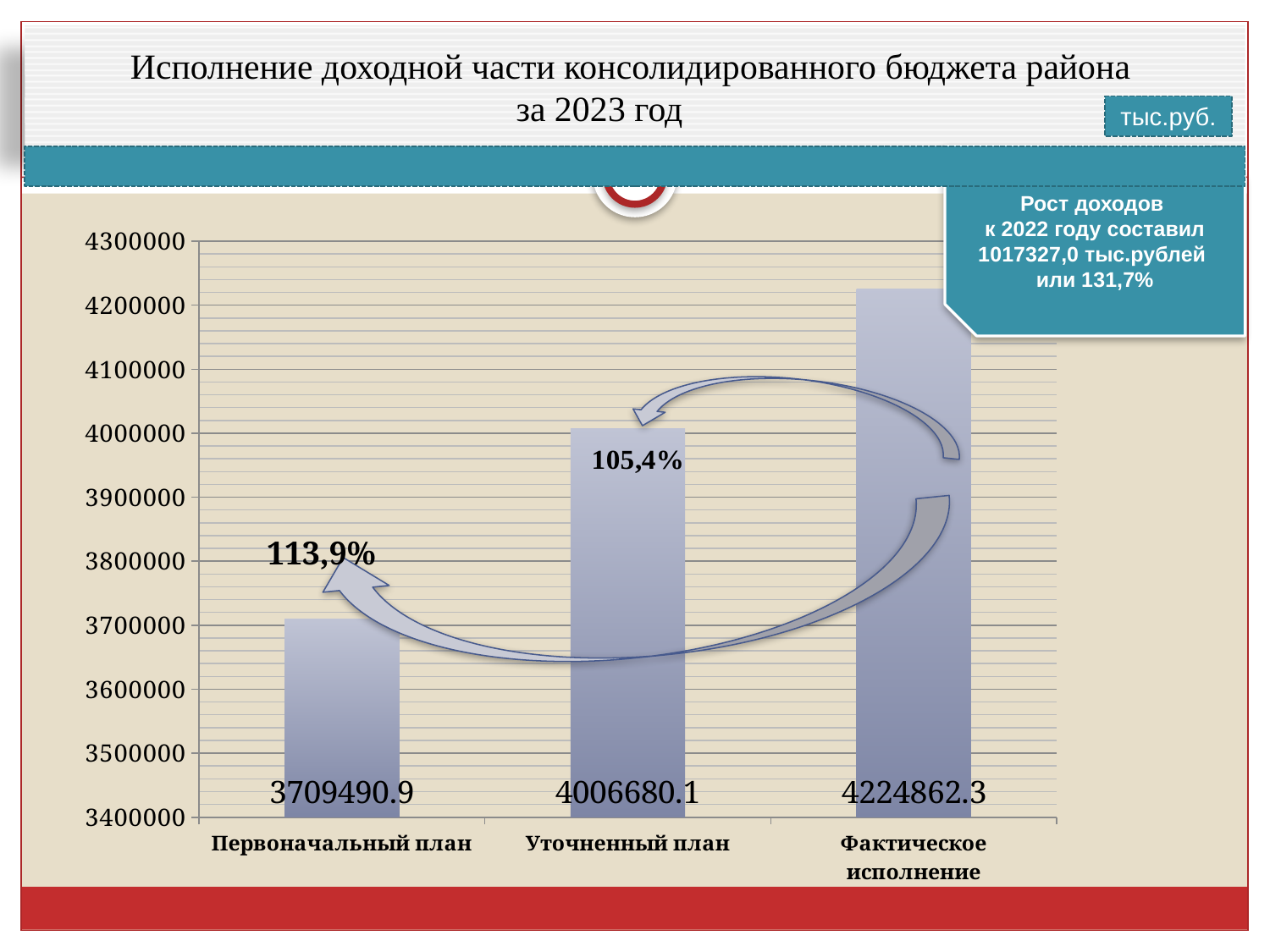
What is the difference between Фактическое исполнение and Первоначальный план? 515371.4 What kind of chart is shown on the slide? bar chart Is the value for Уточненный план greater or less than 4000000? greater How many categories are shown on the x axis? 3 What is the value for Уточненный план? 4006680.1 Which is larger, Уточненный план or Первоначальный план? Уточненный план What unit of measurement is indicated for the chart? тыс.руб. What is the value for Фактическое исполнение? 4224862.3 Which category has the highest value? Фактическое исполнение Which category has the lowest value? Первоначальный план What is the value for Первоначальный план? 3709490.9 What is the difference between Фактическое исполнение and Уточненный план? 218182.2